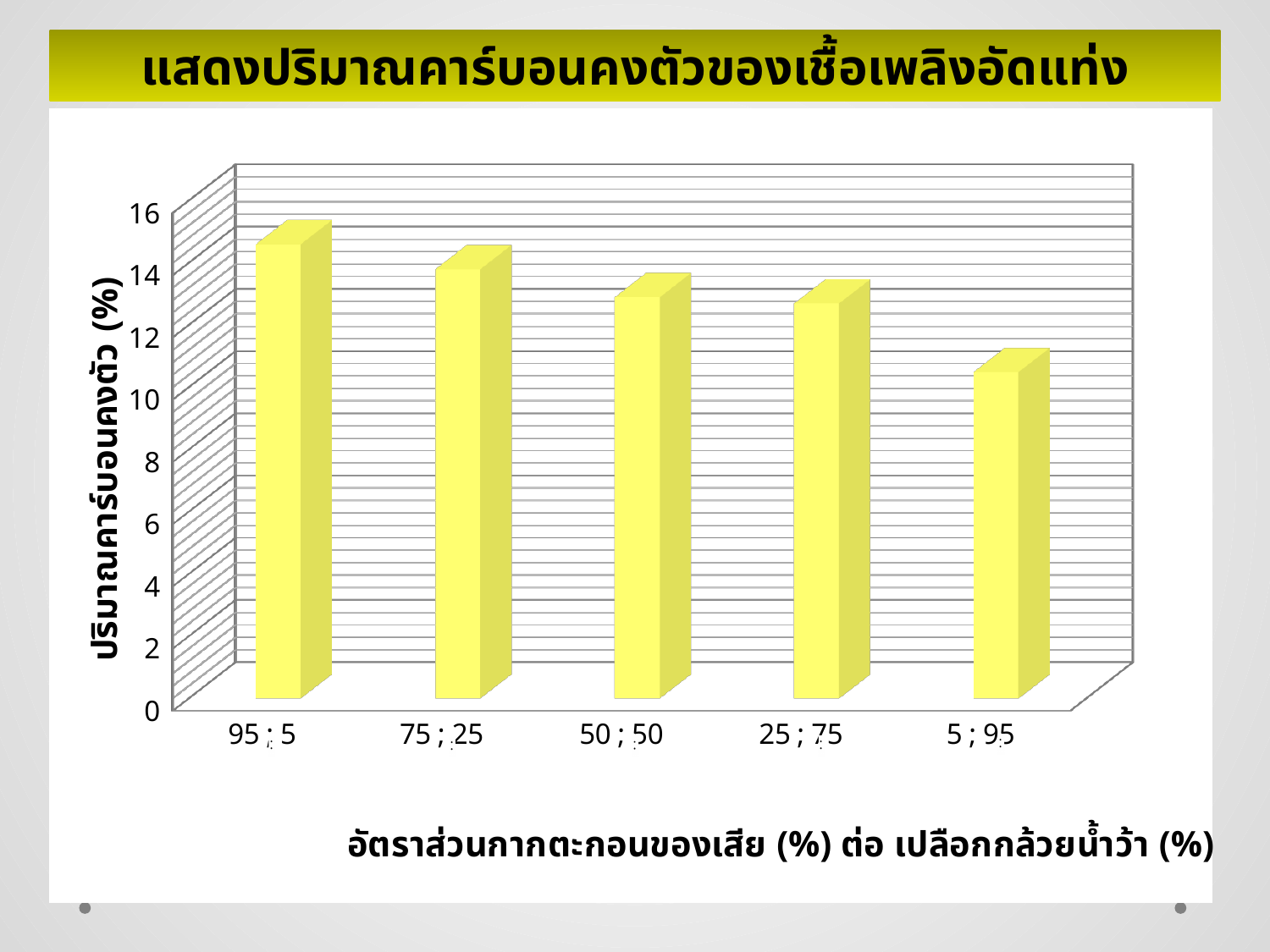
Is the value for 5 ; 95 greater or less than 12? less Is the value for 5 ; 95 greater or less than 10? greater Is the value for 50 ; 50 greater or less than 12? greater What is the label on the y axis of the chart? ปริมาณคาร์บอนคงตัว (%) How many categories are shown on the x axis? 5 Which category has the lowest fixed carbon value? 5 ; 95 Do the values rise or fall moving from left to right along the x axis? fall Which is larger, the value for 95 ; 5 or the value for 5 ; 95? 95 ; 5 Which category has the highest fixed carbon value? 95 ; 5 What kind of chart is shown on the slide? bar chart